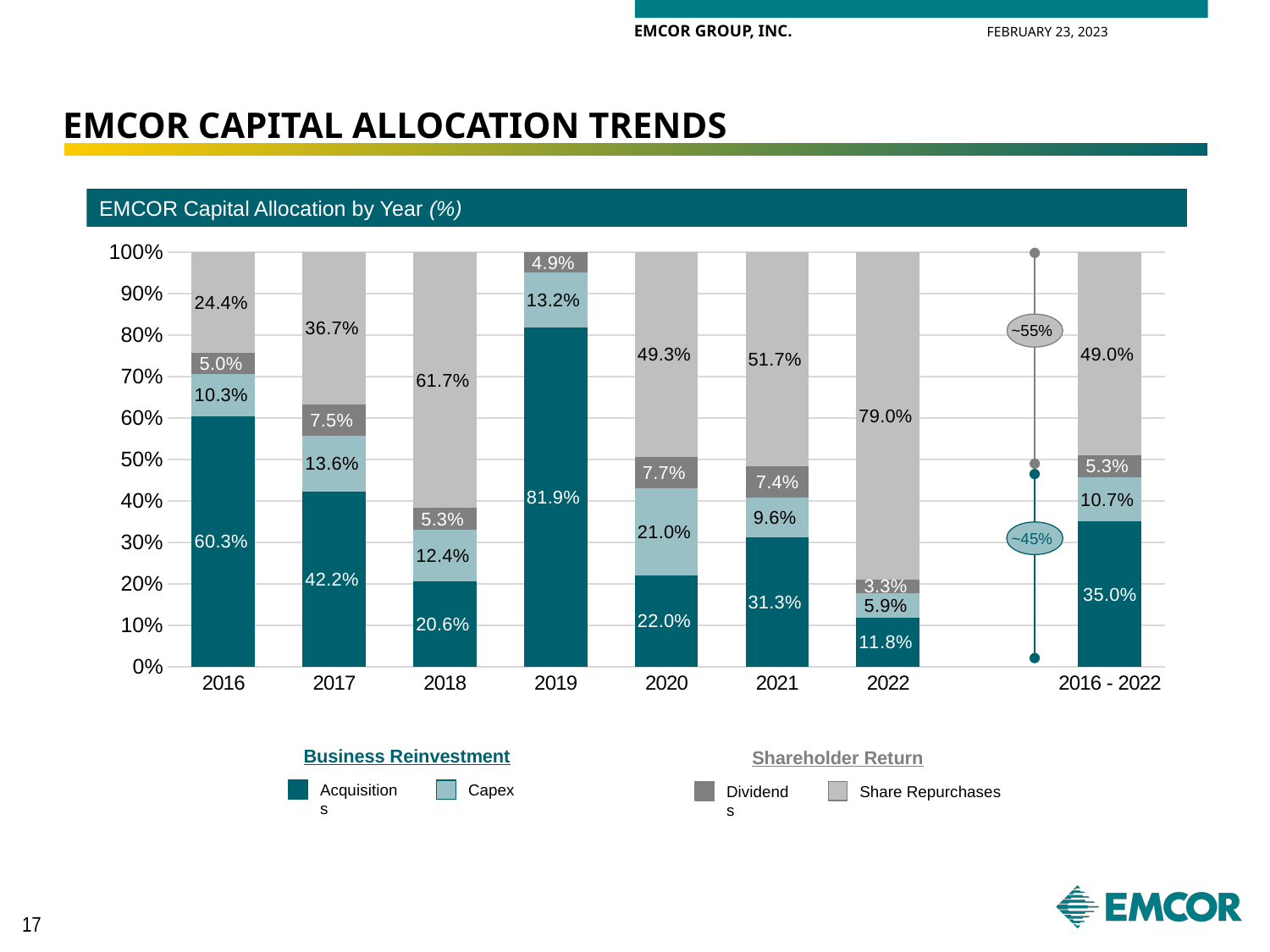
What is the Share Repurchases value for 2022? 79.0% Which two legend entries are grouped under Business Reinvestment? Acquisitions and Capex What type of chart is shown on the slide? stacked bar chart Which year has the highest Acquisitions share? 2019 What is the difference between the Share Repurchases values for 2018 and 2017? 25.0% Which is larger, the Capex value for 2017 or the Capex value for 2021? 2017 What is the Acquisitions share for 2019? 81.9% What is the Dividends value for the 2016 - 2022 bar? 5.3% How many bars are plotted on the chart? 8 How many series does the legend list? 4 What is the Capex value for 2020? 21.0% Which year has the lowest Acquisitions share? 2022